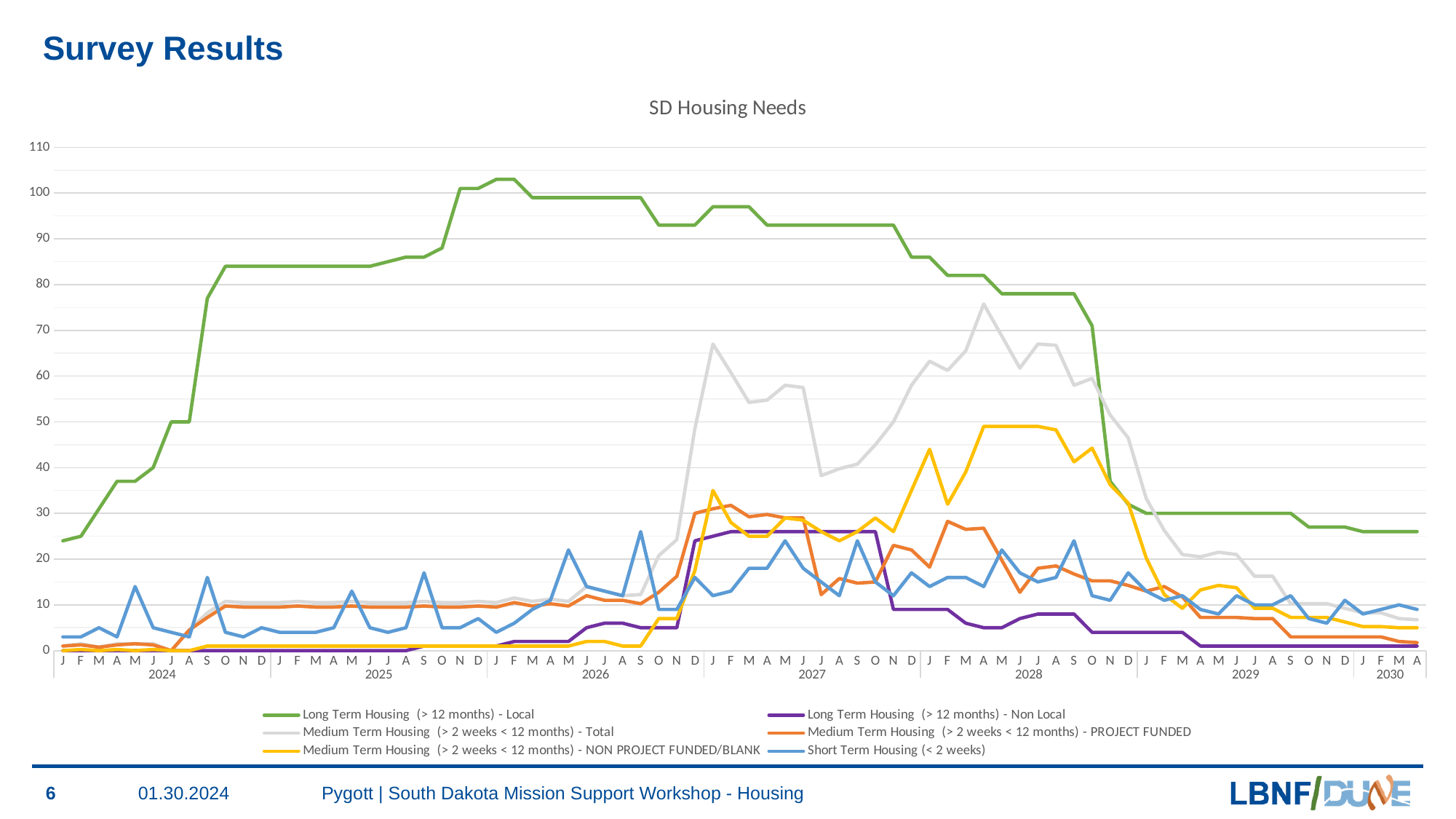
How many series does the legend list? 6 Does the Long Term Housing (> 12 months) - Local series rise or fall from January 2024 to January 2026? rise Is the value for Long Term Housing (> 12 months) - Local in January 2027 greater or less than 90? greater Is the value for Long Term Housing (> 12 months) - Local in January 2024 greater or less than 30? less Which series reaches the highest value on the chart? Long Term Housing (> 12 months) - Local What is the title of the chart? SD Housing Needs Is the peak value for Medium Term Housing (> 2 weeks < 12 months) - Total in 2028 greater or less than 70? greater In January 2027, which is higher: Long Term Housing (> 12 months) - Local or Medium Term Housing (> 2 weeks < 12 months) - Total? Long Term Housing (> 12 months) - Local Does the Long Term Housing (> 12 months) - Local series rise or fall from January 2028 to January 2030? fall What kind of chart is shown on the slide? line chart